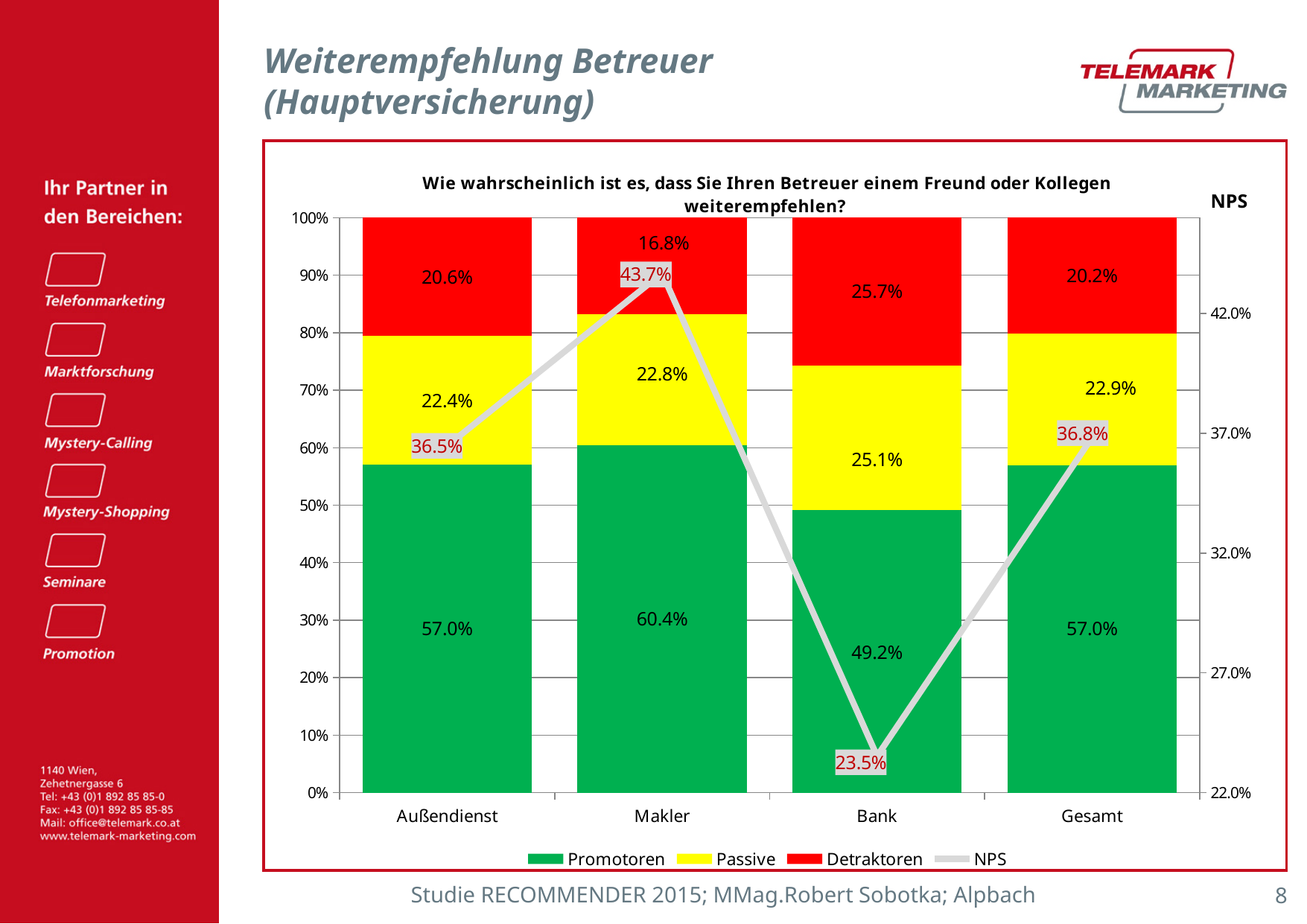
Which series is shown in red? Detraktoren What is the Detraktoren value for Außendienst? 20.6% What is the difference between the Detraktoren values for Bank and Makler? 8.9% How many series does the legend list? 4 What is the NPS value for Bank? 23.5% Which category has the highest NPS value? Makler Which is larger, the NPS value for Außendienst or for Gesamt? Gesamt What is the Promotoren value for Makler? 60.4% Which category has the lowest Promotoren value? Bank How many categories are shown on the x axis? 4 What is the Passive value for Gesamt? 22.9% What kind of chart is this? Stacked bar chart with a line